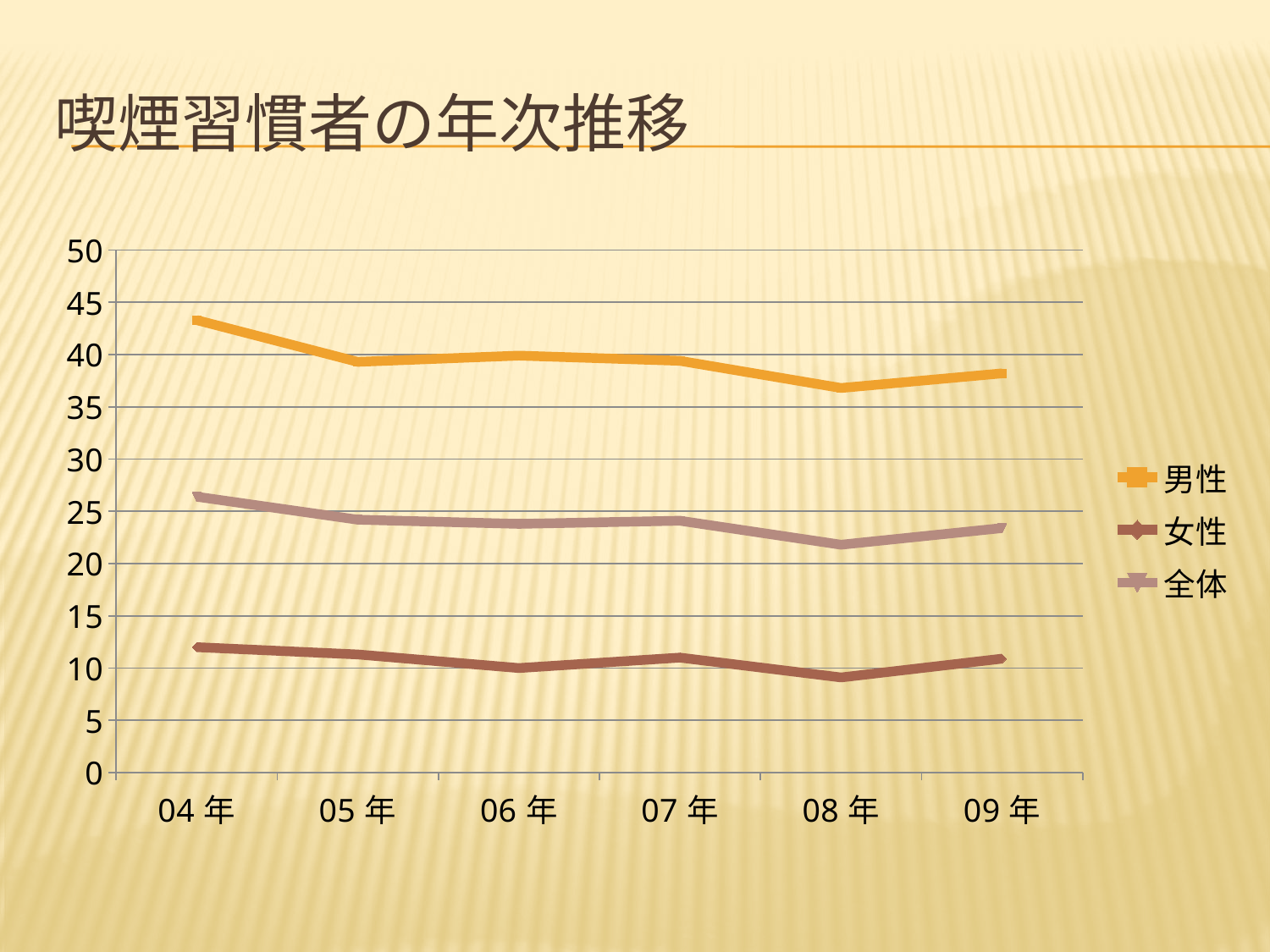
Which series has the higher value in 09年, 男性 or 女性? 男性 How many years are plotted along the x axis? 6 How many series does the legend list? 3 In which year is the 男性 series at its highest? 04年 Is the value for 男性 in 04年 greater or less than 40? greater Is the value for 全体 in 04年 greater or less than 25? greater Is the value for 男性 in 08年 greater or less than 40? less What kind of chart is shown on the slide? line chart In which year is the 全体 series at its lowest? 08年 Does the 男性 series rise or fall overall from 04年 to 09年? fall